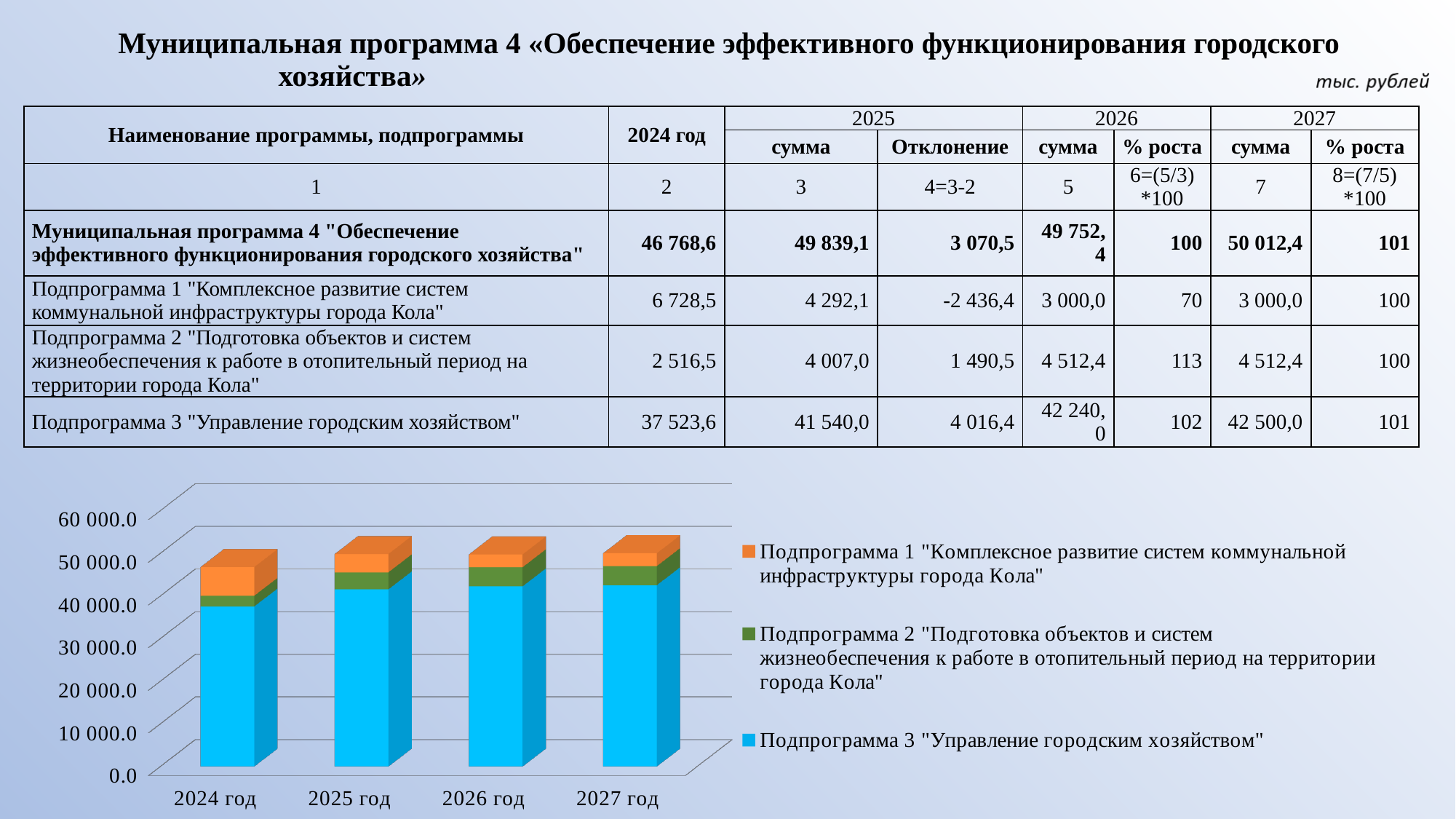
Which year has the larger segment for Подпрограмма 1 "Комплексное развитие систем коммунальной инфраструктуры города Кола": 2024 год or 2025 год? 2024 год What kind of chart is shown at the bottom of the slide? stacked bar chart What colour represents Подпрограмма 1 "Комплексное развитие систем коммунальной инфраструктуры города Кола" in the chart? orange Is the total stacked bar for 2024 год greater or less than 50 000.0? less Is the Подпрограмма 3 "Управление городским хозяйством" segment for 2024 год greater or less than 40 000.0? less How many years (categories) are shown on the x axis of the chart? 4 Is the Подпрограмма 3 "Управление городским хозяйством" segment for 2025 год greater or less than 40 000.0? greater Does the Подпрограмма 3 "Управление городским хозяйством" segment rise or fall from 2024 год to 2027 год? rise According to the table, what is the value for Подпрограмма 3 "Управление городским хозяйством" in 2024 год? 37 523,6 Which year has the lowest total stacked bar in the chart? 2024 год Which series forms the bottom segment of each stacked bar in the chart? Подпрограмма 3 "Управление городским хозяйством" How many series does the chart legend list? 3